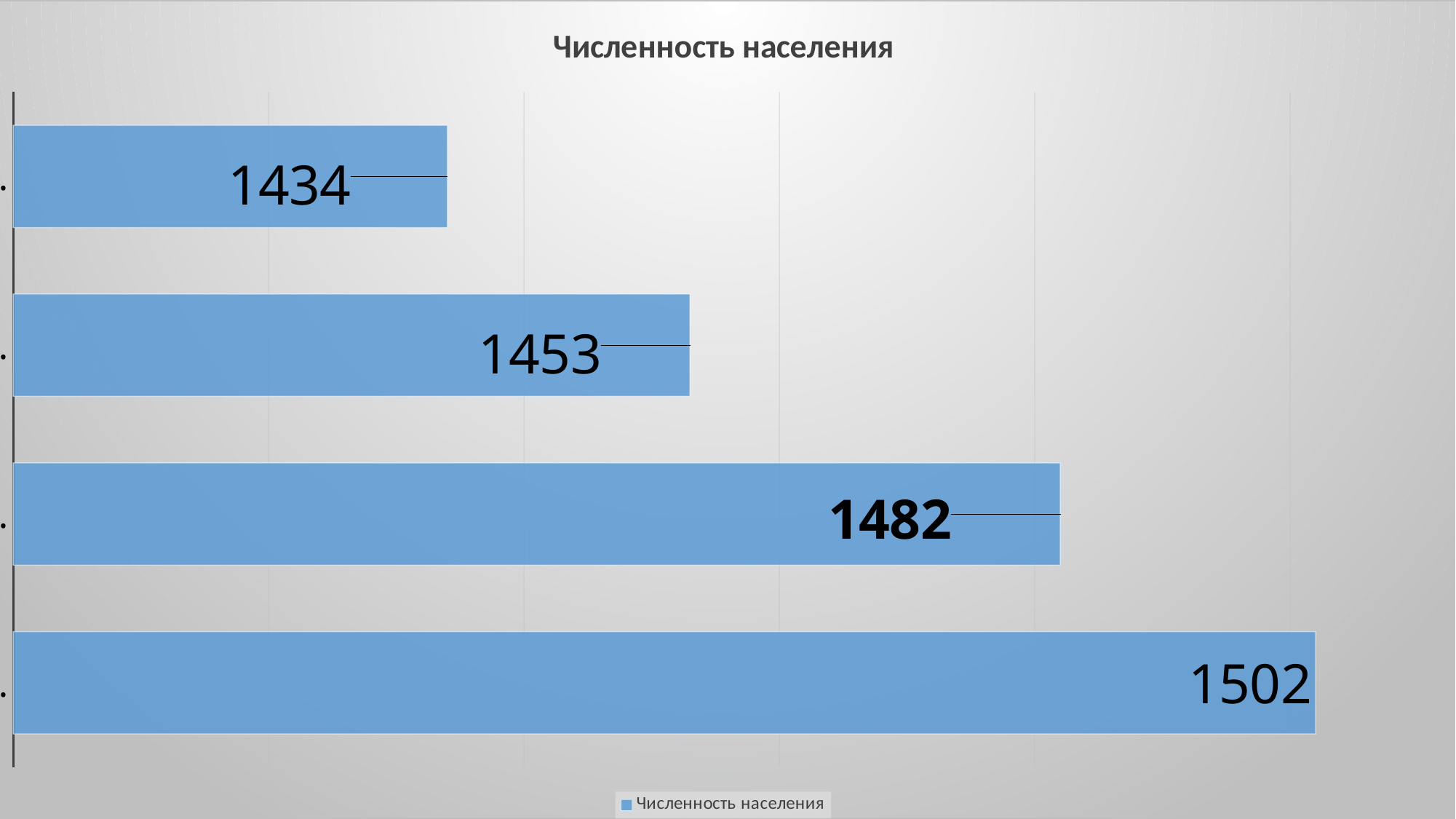
Which is larger, the value of the second bar from the top or the value of the third bar from the top? the third bar from the top (1482) How many series does the legend list? 1 What is the value shown on the second bar from the top? 1453 What type of chart is shown on the slide? bar chart What is the difference between the bottom bar's value and the top bar's value? 68 What is the value shown on the top bar of the chart? 1434 What is the value shown on the bottom bar of the chart? 1502 How many bars are plotted in the chart? 4 What is the highest value plotted in the chart? 1502 What is the lowest value plotted in the chart? 1434 What is the title of the chart? Численность населения What is the value shown on the third bar from the top? 1482